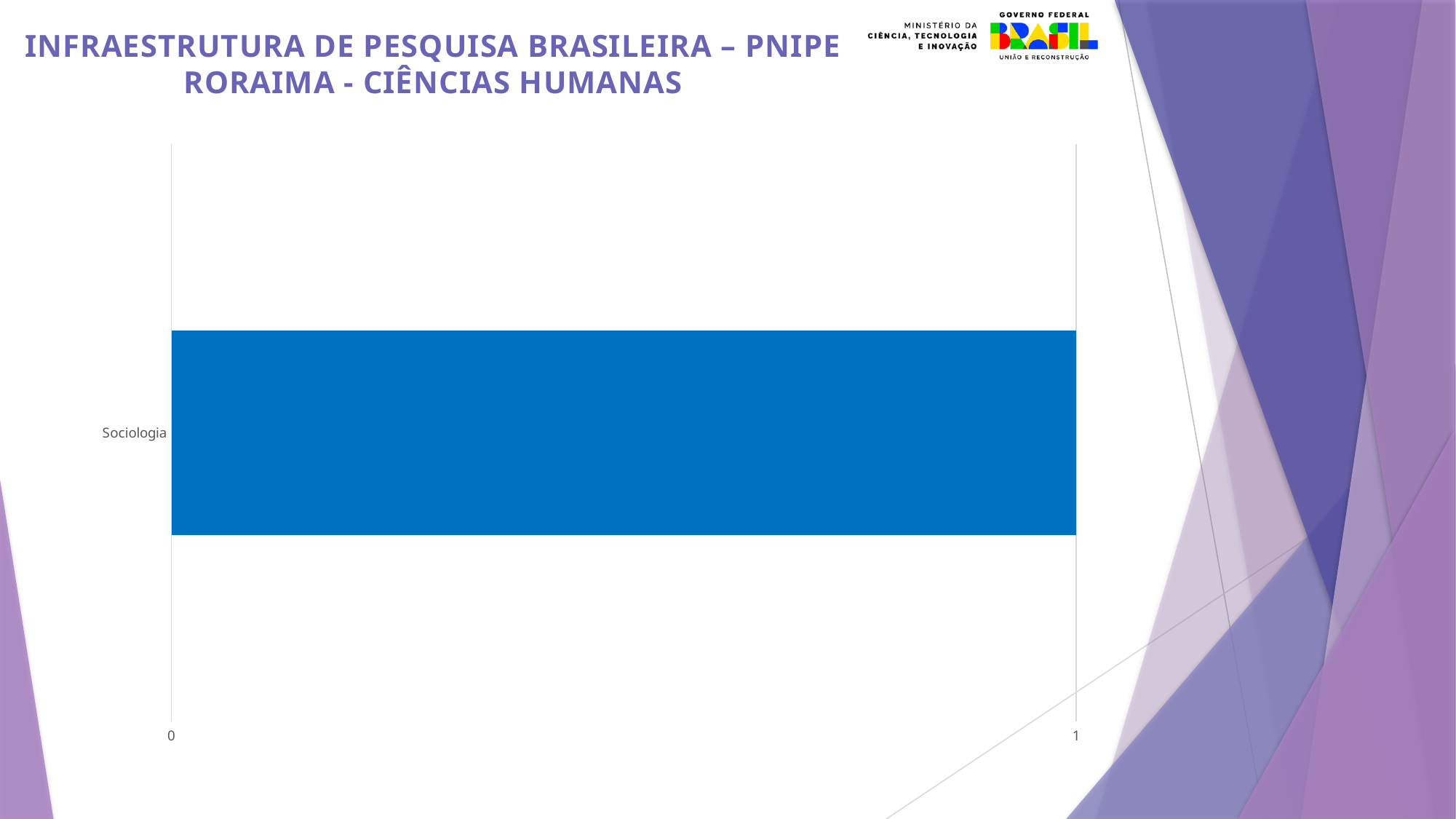
What kind of chart is shown on the slide? bar chart How many categories are shown on the chart? 1 What is the highest value shown on the x axis? 1 What is the value for Sociologia? 1 Is the value for Sociologia greater or less than 0? greater Which category is shown on the chart? Sociologia